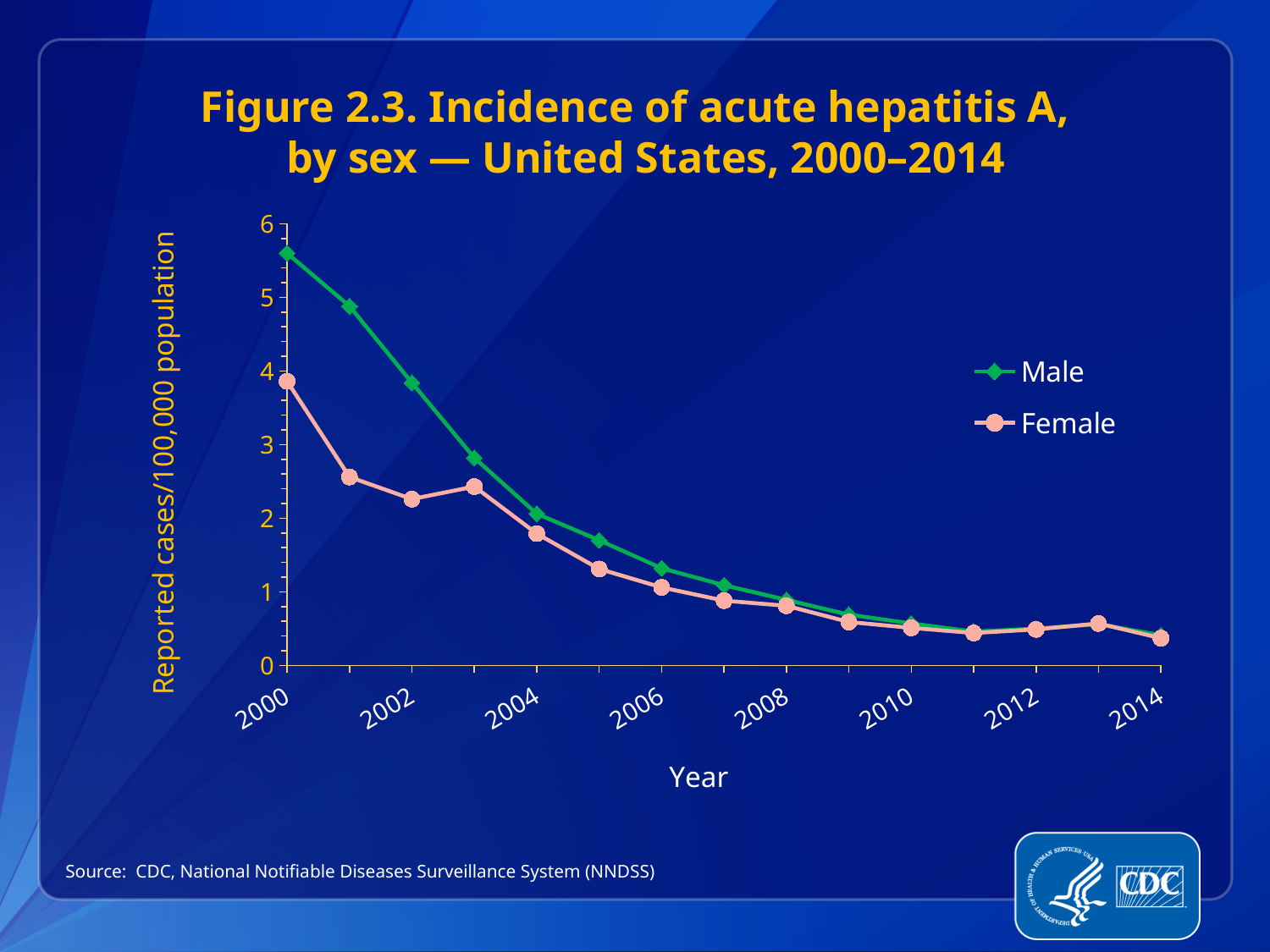
In 2000, which series has the higher incidence, Male or Female? Male What kind of chart is shown on the slide? line chart What is the label of the y axis? Reported cases/100,000 population Is the Female value for 2000 greater or less than 4? less Does the Male incidence rate generally rise or fall from 2000 to 2014? fall Is the Male value for 2014 greater or less than 1? less Is the Male value for 2000 greater or less than 5? greater How many series does the legend list? 2 Which two series are shown in the legend? Male and Female In which year is the Male incidence rate highest? 2000 How many years are plotted along the x axis, from 2000 to 2014? 15